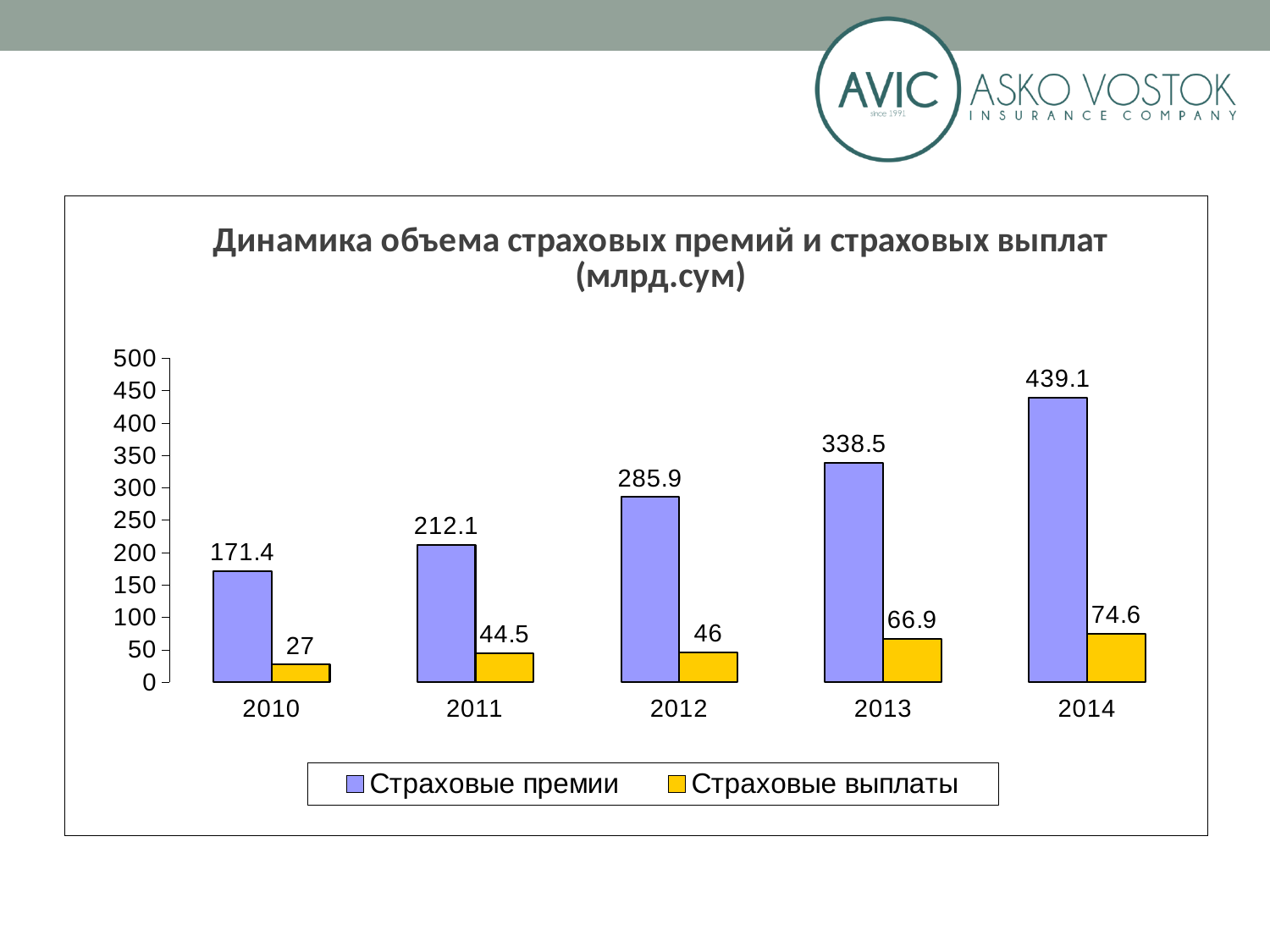
What kind of chart is shown on the slide? bar chart What is the value of Страховые премии for 2012? 285.9 What colour are the bars for Страховые выплаты? yellow How many series does the legend list? 2 Which is larger: Страховые выплаты in 2011 or in 2012? 2012 How many years are shown on the x axis? 5 Which year has the lowest value for Страховые выплаты? 2010 Do the values for Страховые премии rise or fall from 2010 to 2014? rise Is the value for Страховые премии in 2013 greater or less than 300? greater Which year has the highest value for Страховые премии? 2014 What is the difference between Страховые премии in 2014 and in 2013? 100.6 What is the value of Страховые выплаты for 2013? 66.9